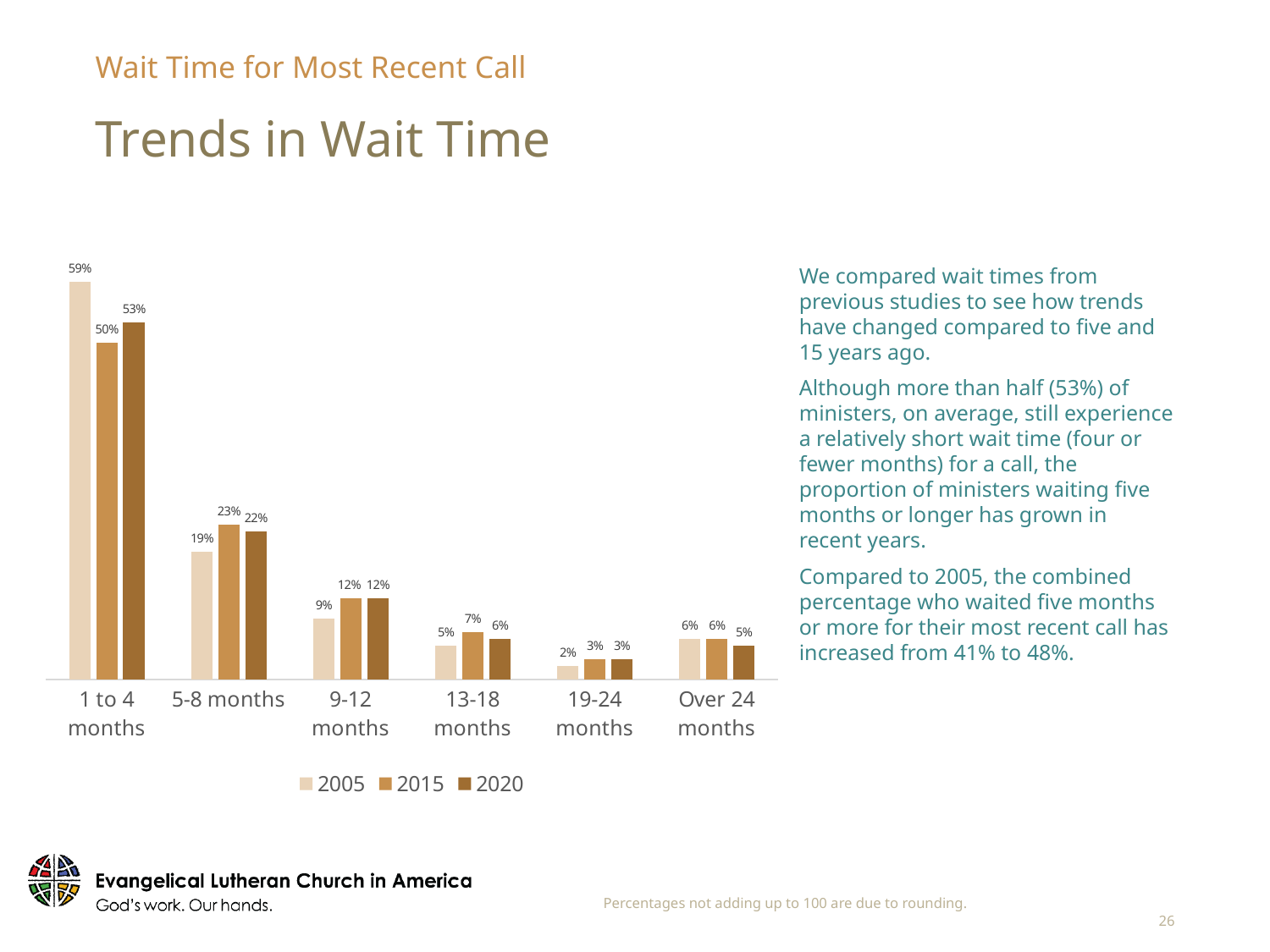
Which is larger in the 5-8 months category: the 2005 value or the 2015 value? 2015 What is the value for 2005 in the 1 to 4 months category? 59% What is the value for 2020 in the 5-8 months category? 22% Which years are listed in the chart legend? 2005, 2015, 2020 What kind of chart is shown on the slide? Bar chart Do the 2020 values rise or fall from the 1 to 4 months category to the 19-24 months category? Fall Which category has the lowest value for the 2005 series? 19-24 months What is the value for 2015 in the 13-18 months category? 7% How many categories are shown on the x axis? 6 How many series does the legend list? 3 What is the difference between the 2005 and 2015 values in the 1 to 4 months category? 9% Which category has the highest value for the 2020 series? 1 to 4 months